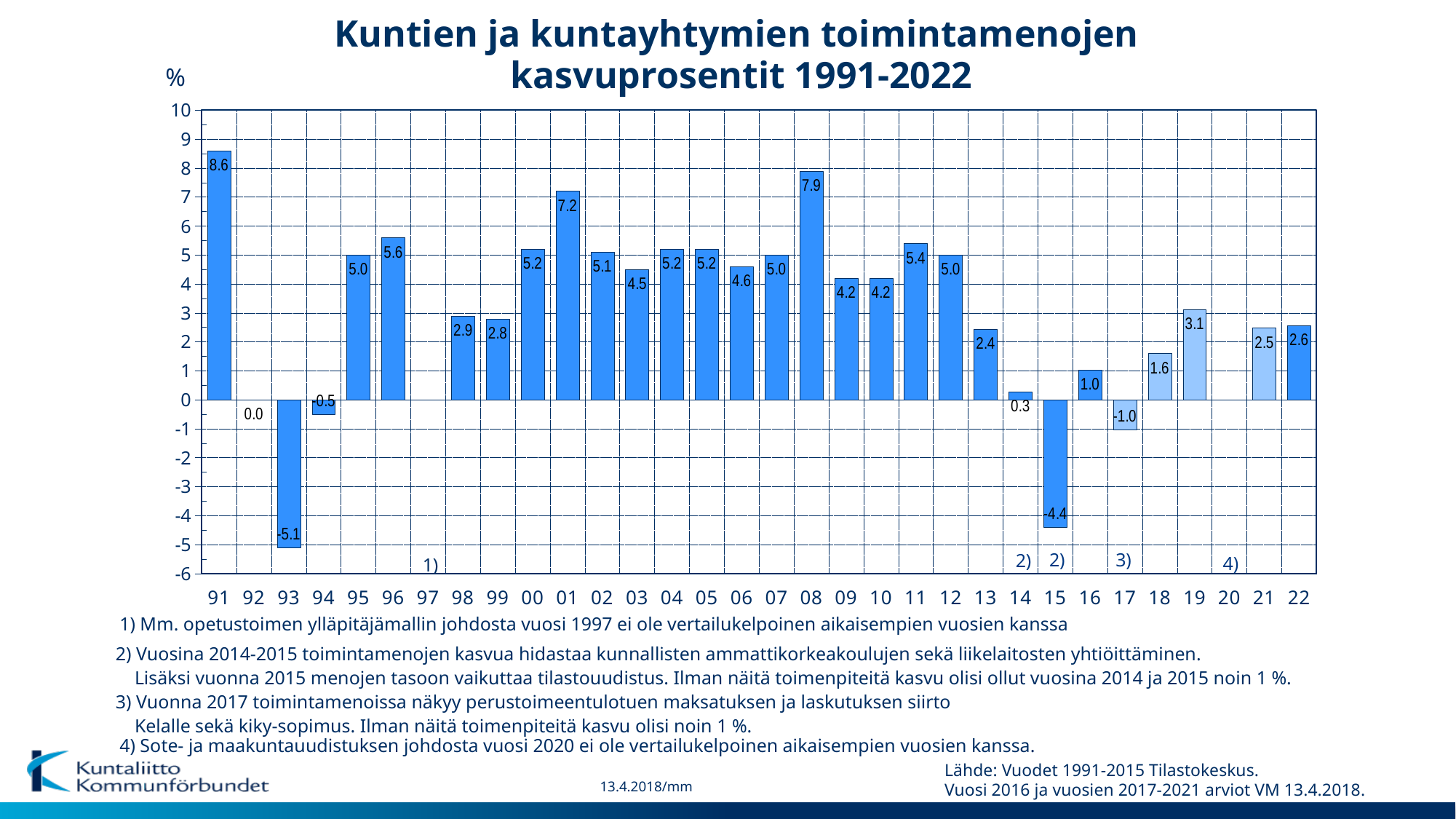
What is the growth percentage shown for 1991? 8.6 What is the value shown for 2022? 2.6 Which year has the larger value, 1996 or 2011? 1996 What is the difference between the values for 2001 and 2002? 2.1 Is the value for 2019 greater or less than 3? greater What is the title of the chart? Kuntien ja kuntayhtymien toimintamenojen kasvuprosentit 1991-2022 What is the value shown for 2008? 7.9 What is the value shown for 2015? -4.4 Which year has the lowest growth percentage? 1993 What kind of chart is shown on the slide? bar chart Which year has the highest growth percentage? 1991 Do the values rise or fall from 2016 to 2017? fall